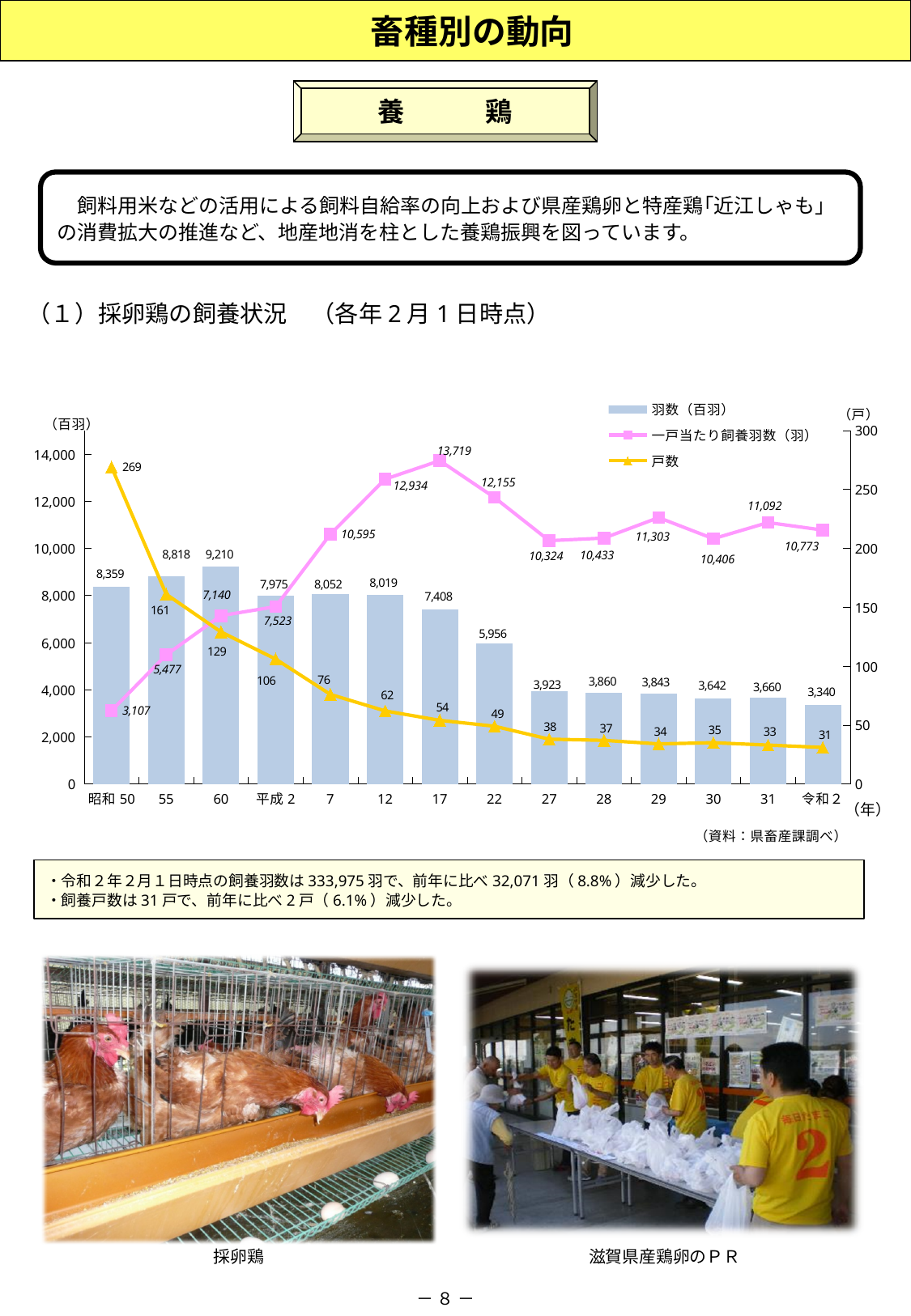
How many series does the legend list? 3 What is the value of 戸数 for 令和2? 31 What kind of chart is this? Combined bar and line chart What is the difference between the 羽数（百羽） values for 31 and 令和2? 320 Which category has the highest value of 羽数（百羽）? 60 What is the value of 一戸当たり飼養羽数（羽） for 17? 13,719 Does the 戸数 series rise or fall from 昭和50 to 令和2? Fall What is the difference between the 戸数 values for 昭和50 and 55? 108 How many categories are shown on the x axis? 14 Which category has the lowest value of 戸数? 令和2 What is the value of 羽数（百羽） for 昭和50? 8,359 Which is larger, the 一戸当たり飼養羽数（羽） value for 29 or for 30? 29